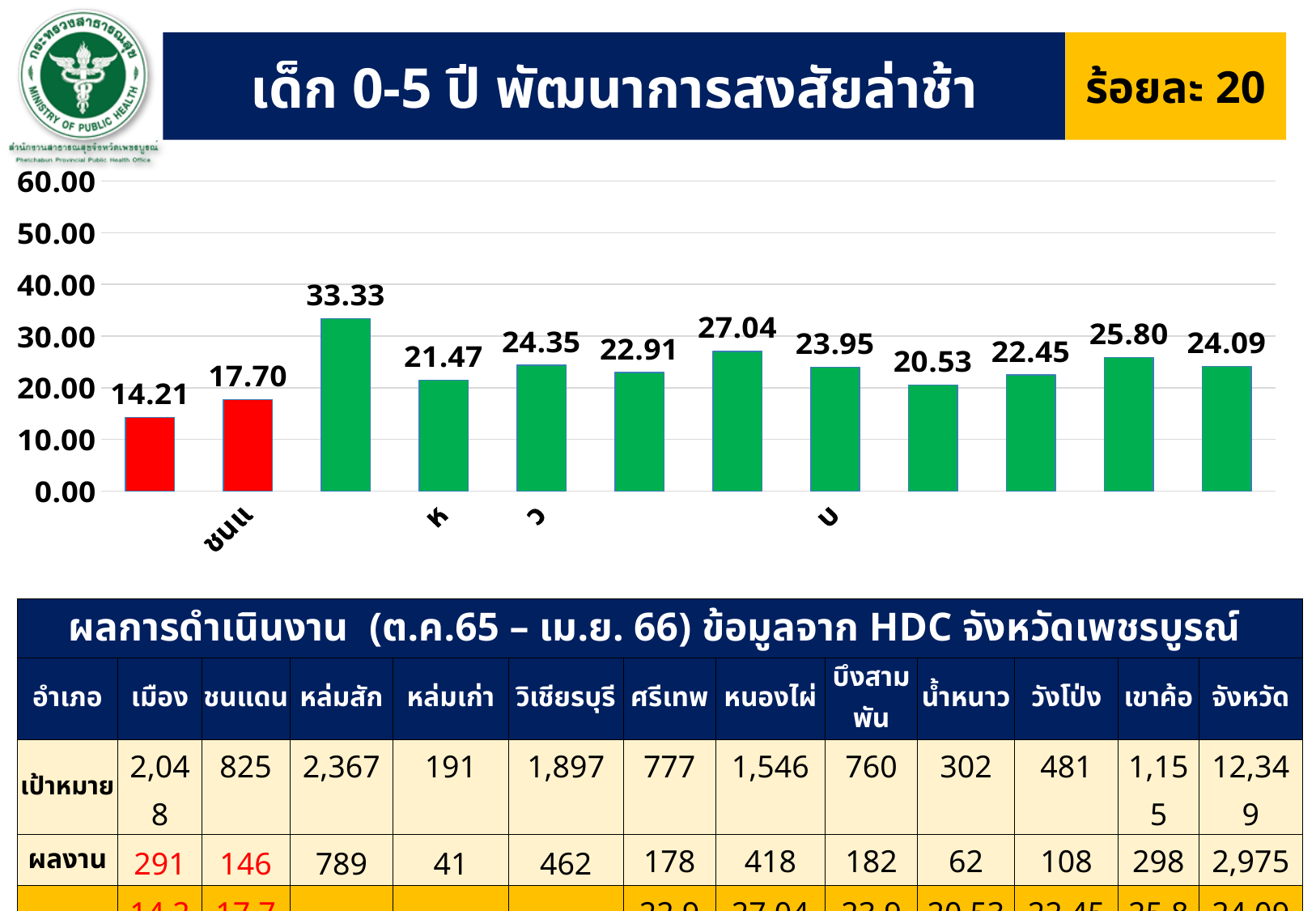
Which is larger: the fifth bar (24.35) or the sixth bar (22.91)? The fifth bar (24.35) What is the value labelled on the seventh bar from the left? 27.04 What is the lowest value shown in the chart? 14.21 How many bars in the chart are coloured red? 2 What kind of chart is shown on the slide? bar chart Is the value of the third bar greater or less than 30.00? greater What is the difference between the highest bar (33.33) and the lowest bar (14.21)? 19.12 What is the value labelled on the second bar from the left? 17.70 What is the title of the chart? เด็ก 0-5 ปี พัฒนาการสงสัยล่าช้า How many bars are plotted in the chart? 12 What is the value labelled on the last (rightmost) bar? 24.09 Which bar has the highest value in the chart, and what is that value? The third bar, 33.33